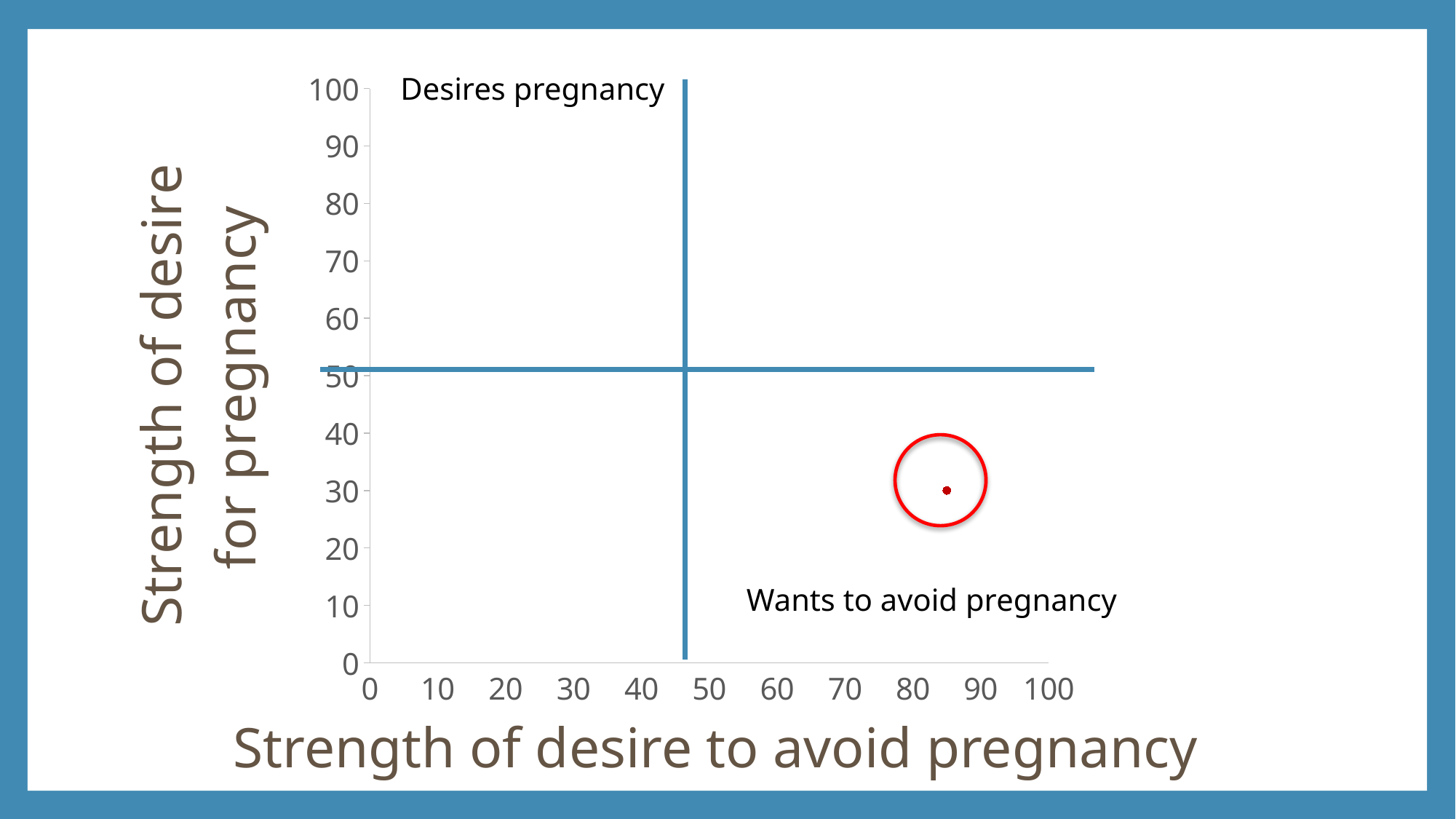
Is the y-axis value (strength of desire for pregnancy) of the plotted point greater or less than 50? less What is the title of the x axis? Strength of desire to avoid pregnancy Is the x-axis value of the plotted point greater or less than 90? less Is the x-axis value of the plotted point greater or less than 80? greater How many data points are plotted on the chart? 1 What kind of chart is shown on the slide? scatter chart Which labelled quadrant does the circled data point fall in? Wants to avoid pregnancy